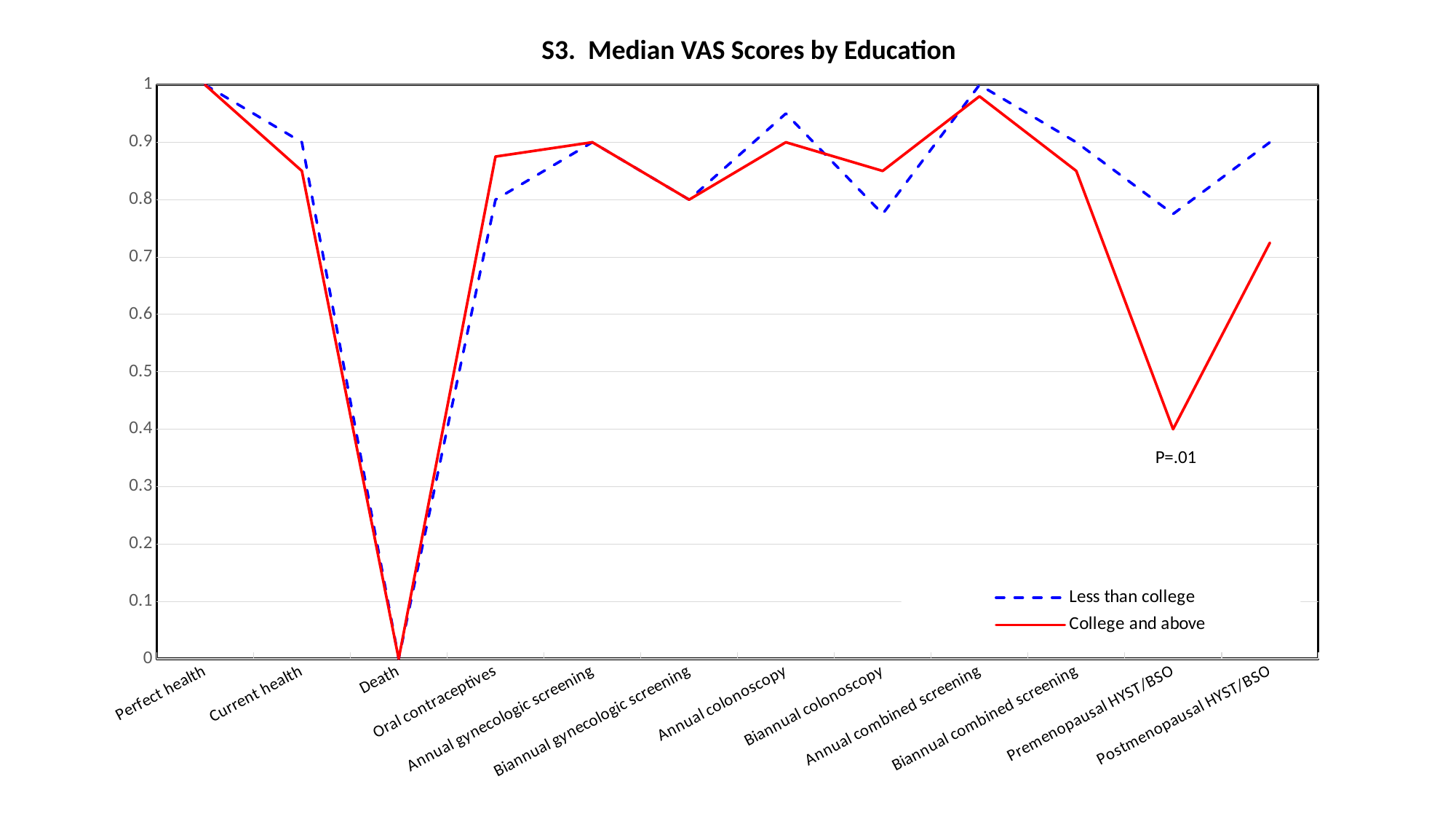
What is the title of the chart? S3. Median VAS Scores by Education For Premenopausal HYST/BSO, which series has the higher median VAS score? Less than college For Biannual colonoscopy, which series has the higher median VAS score? College and above Is the value for Premenopausal HYST/BSO in the Less than college series greater or less than 0.7? greater How many categories are shown along the x axis? 12 What is the median VAS score for Perfect health for the Less than college series? 1 What is the median VAS score for Death for the College and above series? 0 What is the median VAS score for Premenopausal HYST/BSO for the College and above series? 0.4 Is the value for Oral contraceptives in the Less than college series greater or less than 0.9? less Which category has the lowest median VAS score for both series? Death What kind of chart is shown on the slide? line chart How many series does the legend list? 2